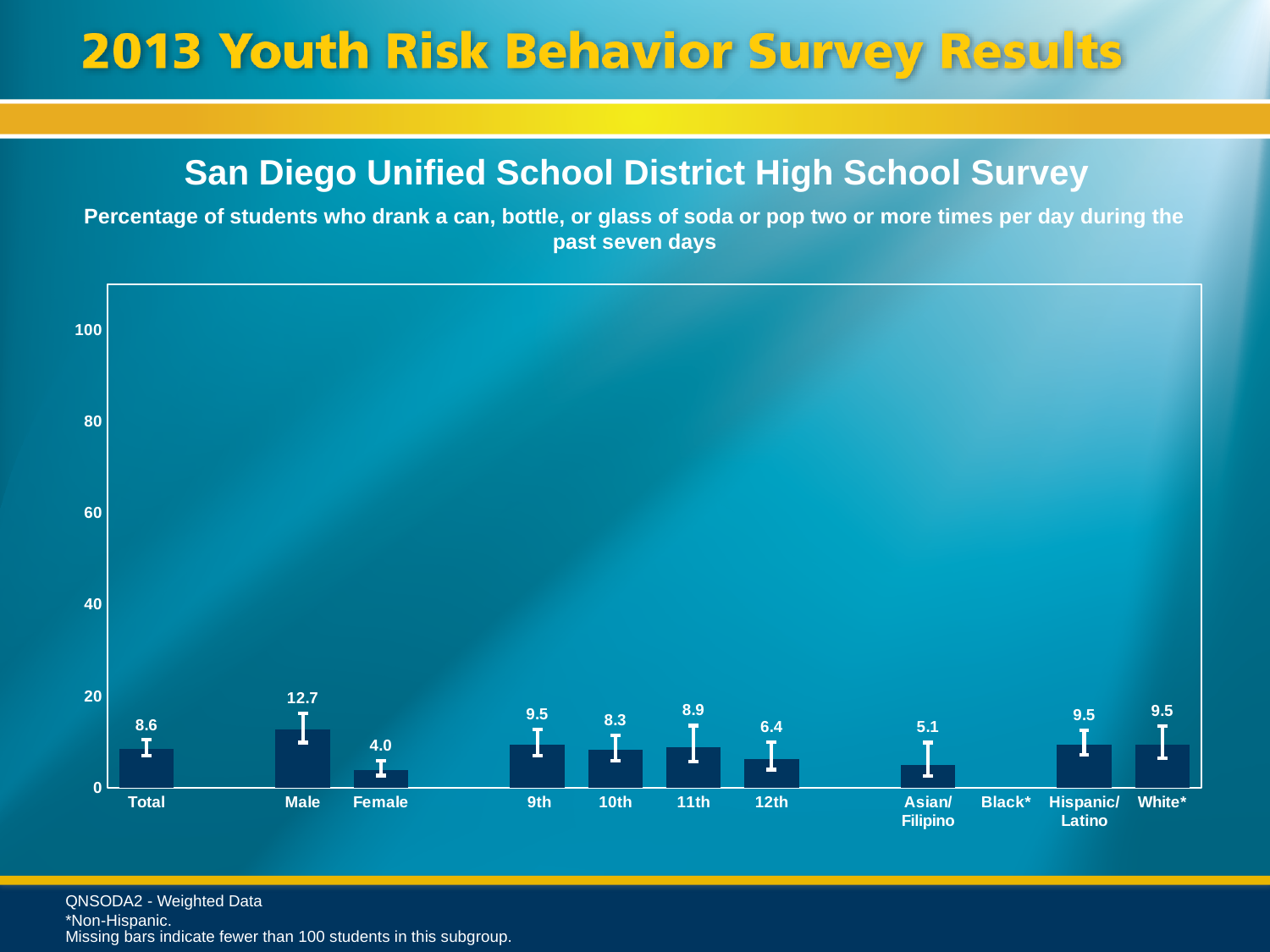
Is the value for Male greater or less than 20? less What is the value for Asian/Filipino? 5.1 What is the difference between the Male and Female values? 8.7 What is the value for Male? 12.7 What is the value for Total? 8.6 What is the value for 12th grade? 6.4 What kind of chart is shown? bar chart Which is larger, the value for 9th grade or 10th grade? 9th What is the value for Female? 4.0 Which category has the highest value? Male Which category with a bar has the lowest value? Female Which category label has no bar shown? Black*